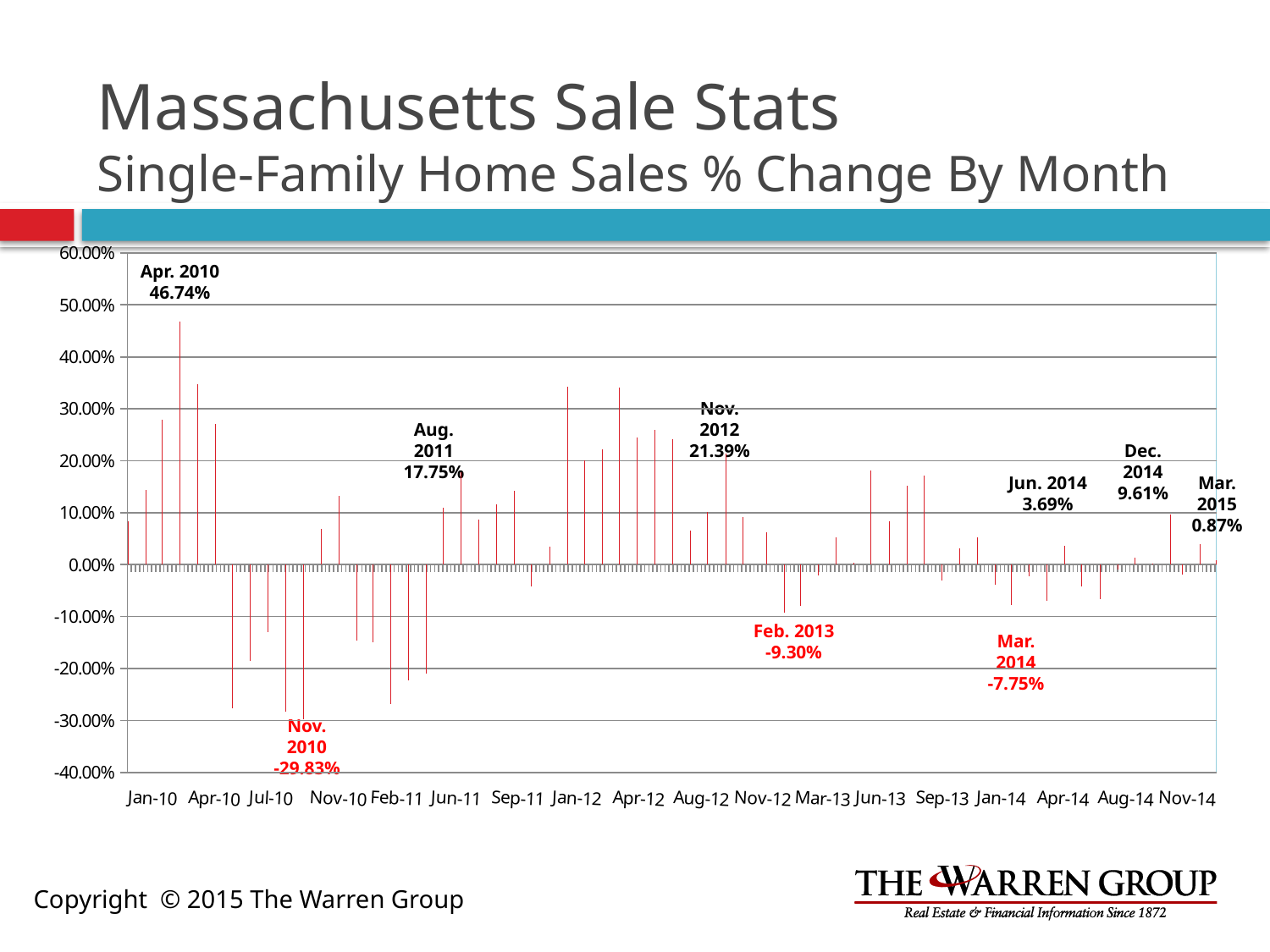
What is the difference between the percentage change for Nov. 2012 and Aug. 2011? 3.64% What kind of chart is shown on the slide? Bar chart What is the percentage change shown for Aug. 2011? 17.75% What is the percentage change shown for Apr. 2010? 46.74% What is the percentage change shown for Feb. 2013? -9.30% Which month has the highest percentage change on the chart? Apr. 2010 Which month has the lowest percentage change on the chart? Nov. 2010 What is the subtitle of the chart on the slide? Single-Family Home Sales % Change By Month What is the percentage change shown for Mar. 2015? 0.87% Which is larger, the percentage change for Dec. 2014 or Jun. 2014? Dec. 2014 Is the value for Mar. 2014 greater or less than -10.00%? greater What is the percentage change shown for Nov. 2010? -29.83%